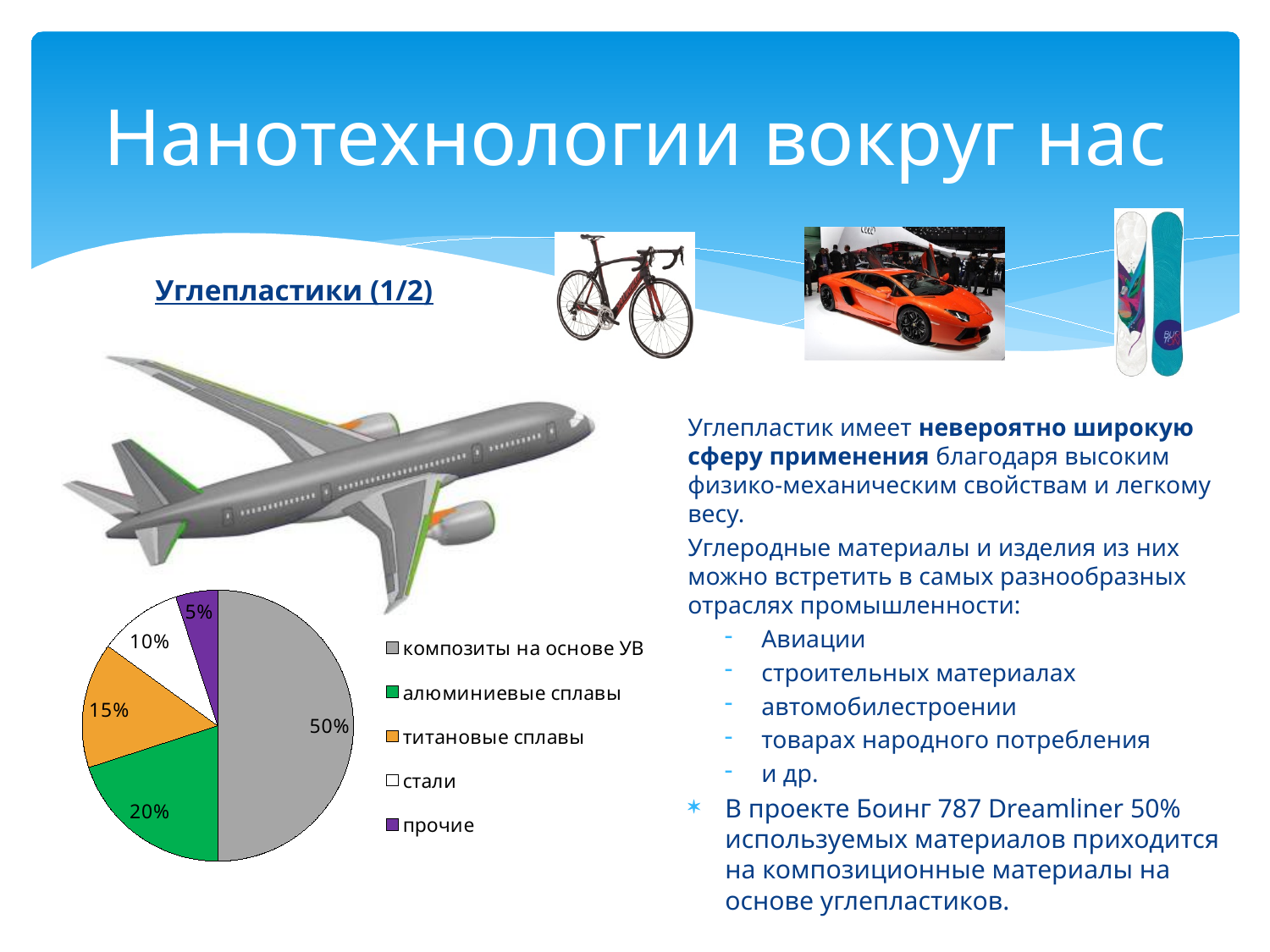
What share of the pie chart is taken by титановые сплавы? 15% What is the difference in percentage points between алюминиевые сплавы and титановые сплавы? 5 What kind of chart is shown on the slide? pie chart Which category has the smallest slice in the pie chart? прочие Which is larger in the pie chart: стали or титановые сплавы? титановые сплавы What share of the pie chart is taken by прочие? 5% What share of the pie chart is taken by стали? 10% What colour is the slice for алюминиевые сплавы in the pie chart? green What share of the pie chart is taken by композиты на основе УВ? 50% What share of the pie chart is taken by алюминиевые сплавы? 20% Which category has the largest slice in the pie chart? композиты на основе УВ How many slices does the pie chart have? 5